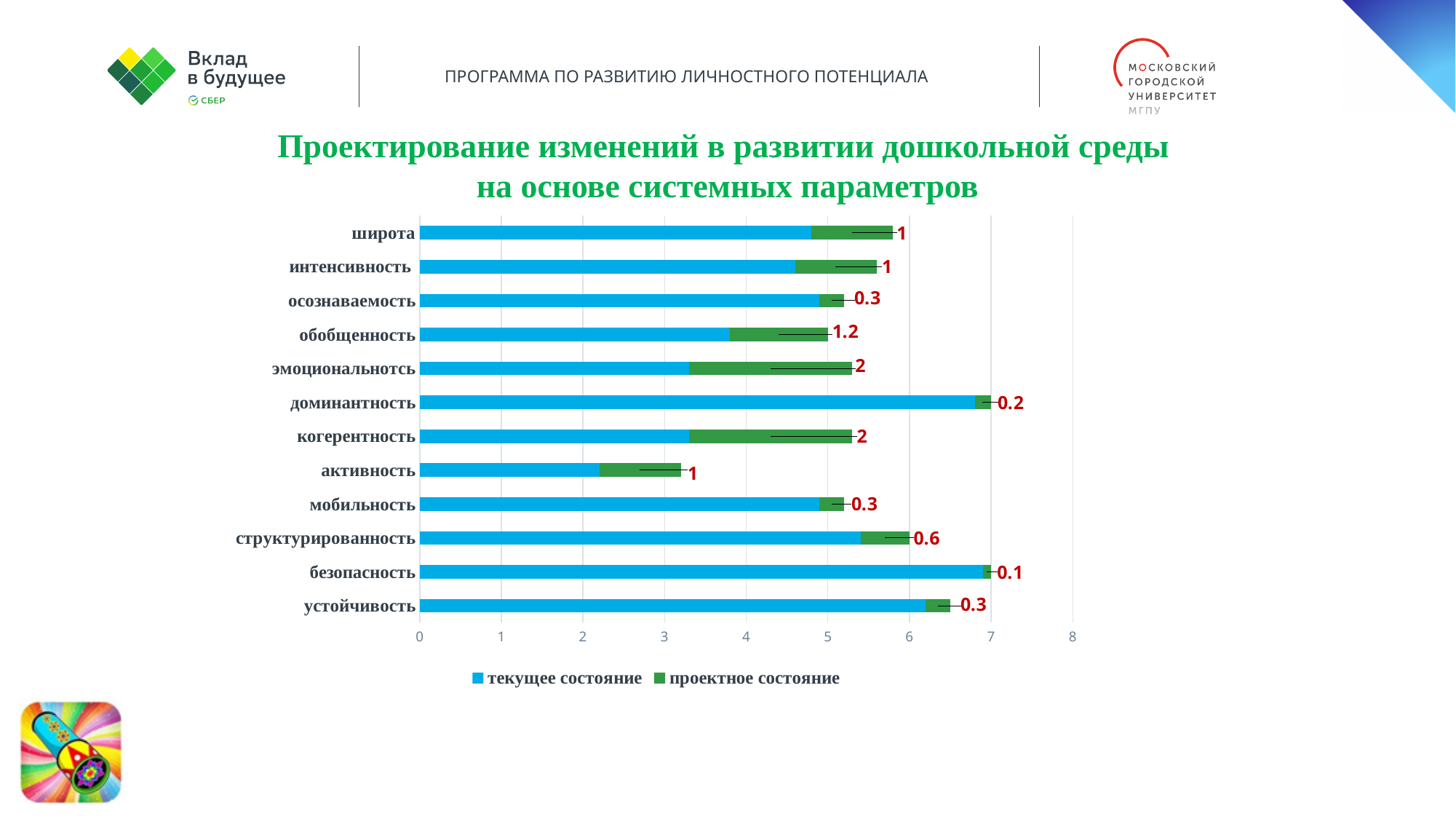
Which category has the lowest value for the проектное состояние series? безопасность What is the value of the проектное состояние series for структурированность? 0.6 How many categories are shown on the chart? 12 Which colour represents the текущее состояние series? Blue Is the текущее состояние value for доминантность greater or less than 6? greater What is the difference between the проектное состояние values for обобщенность and осознаваемость? 0.9 How many series does the legend list? 2 Which has the larger проектное состояние value: активность or мобильность? активность Is the текущее состояние value for активность greater or less than 3? less What kind of chart is shown on the slide? Stacked bar chart What is the value of the проектное состояние series for когерентность? 2 What is the value of the проектное состояние series for обобщенность? 1.2